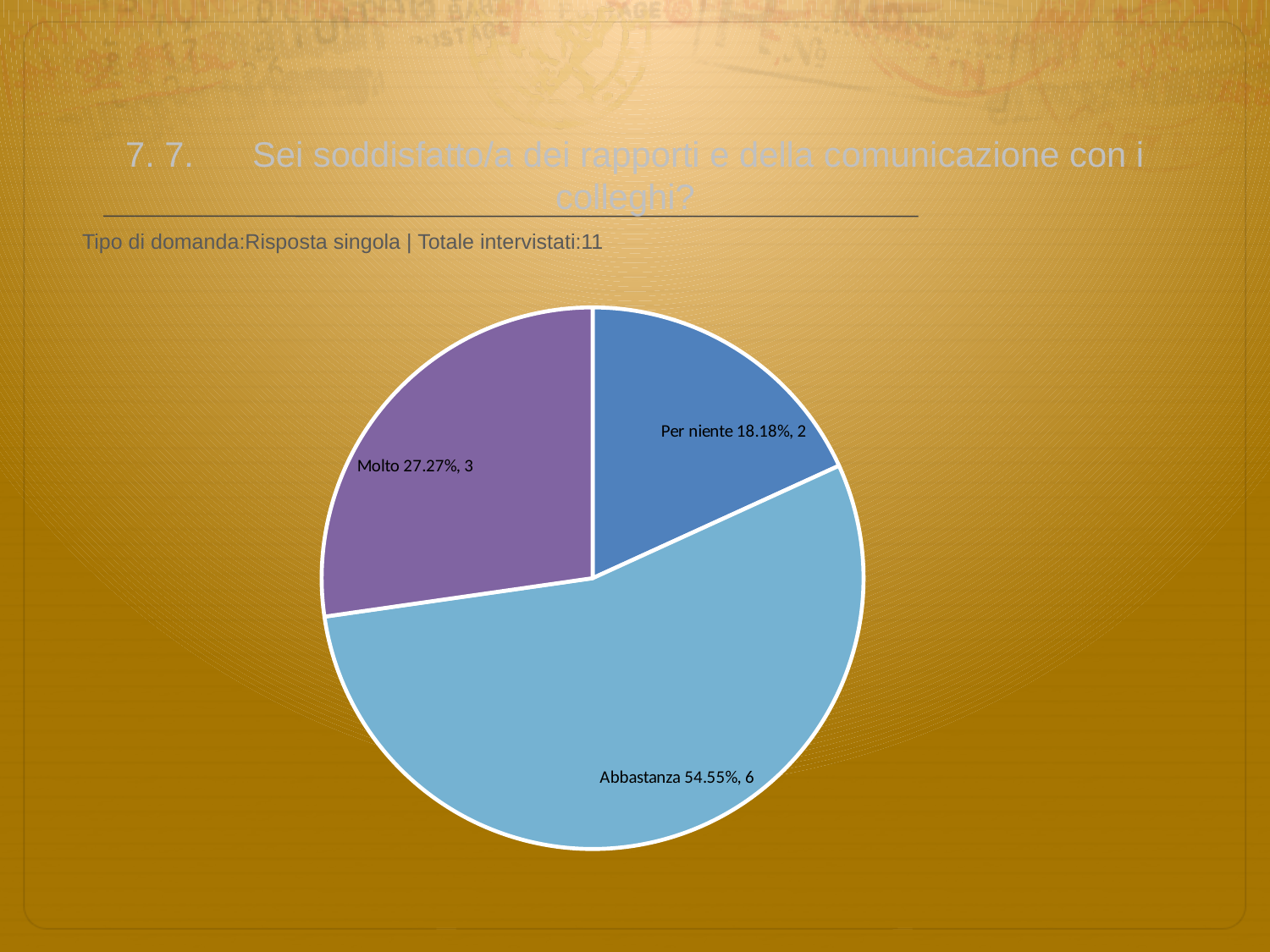
What is the difference in respondent count between Abbastanza and Molto? 3 Which category has the smallest slice of the pie? Per niente How many respondents answered Molto? 3 Which category has the largest slice of the pie? Abbastanza How many respondents answered Per niente? 2 What percentage share does the Molto slice have? 27.27% What kind of chart is shown on the slide? pie chart Which slice is larger, Molto or Per niente? Molto What percentage share does the Per niente slice have? 18.18% How many respondents answered Abbastanza? 6 How many slices does the pie chart have? 3 What percentage share does the Abbastanza slice have? 54.55%